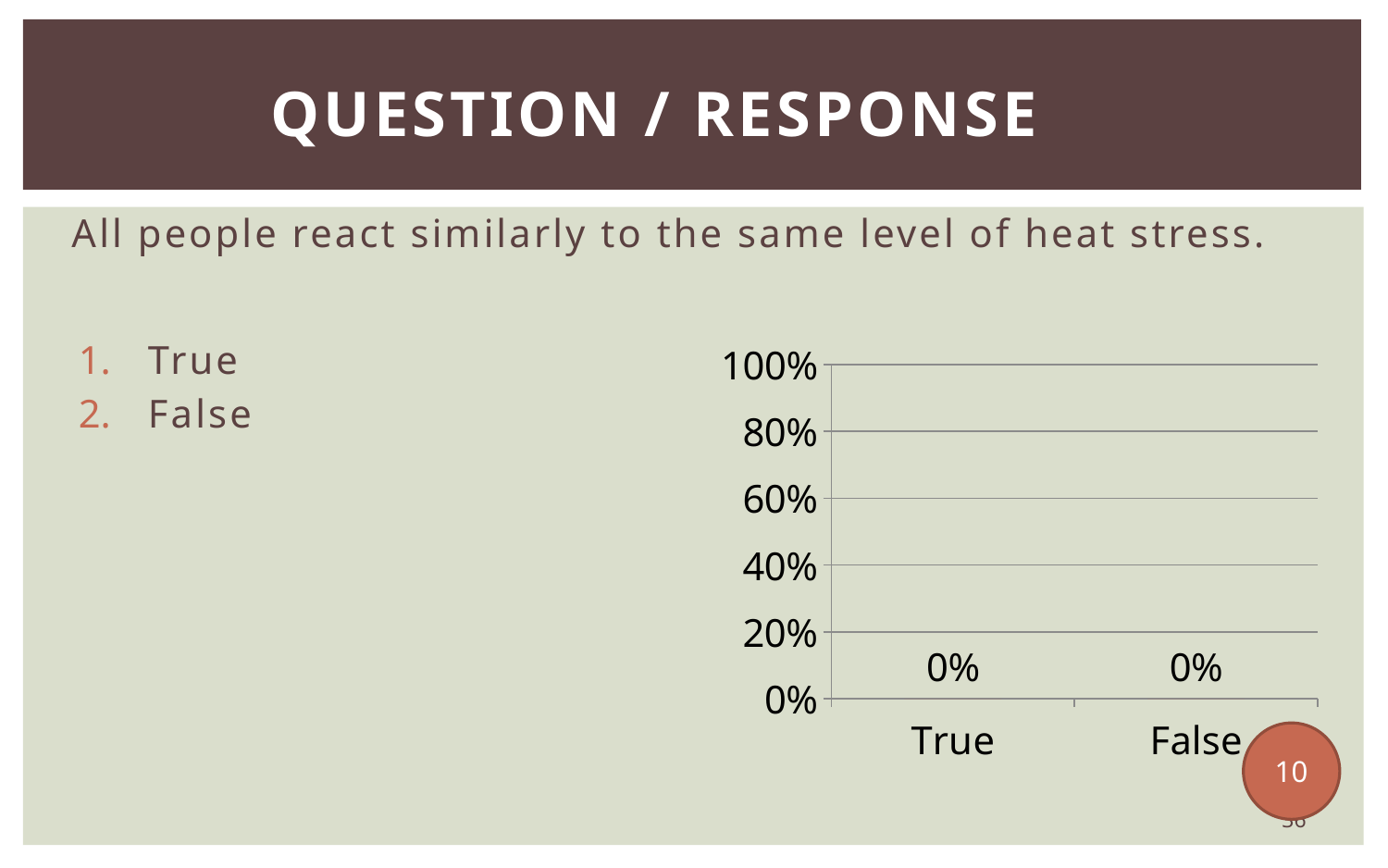
How many categories are shown on the x axis of the chart? 2 What is the difference between the values for True and False? 0% What are the two category labels on the x axis of the chart? True and False What kind of chart is shown on the slide? bar chart Is the value for False greater or less than 40%? less What is the value for False? 0% What is the highest tick label on the vertical axis of the chart? 100% Is the value for True greater or less than 20%? less What is the value for True? 0%